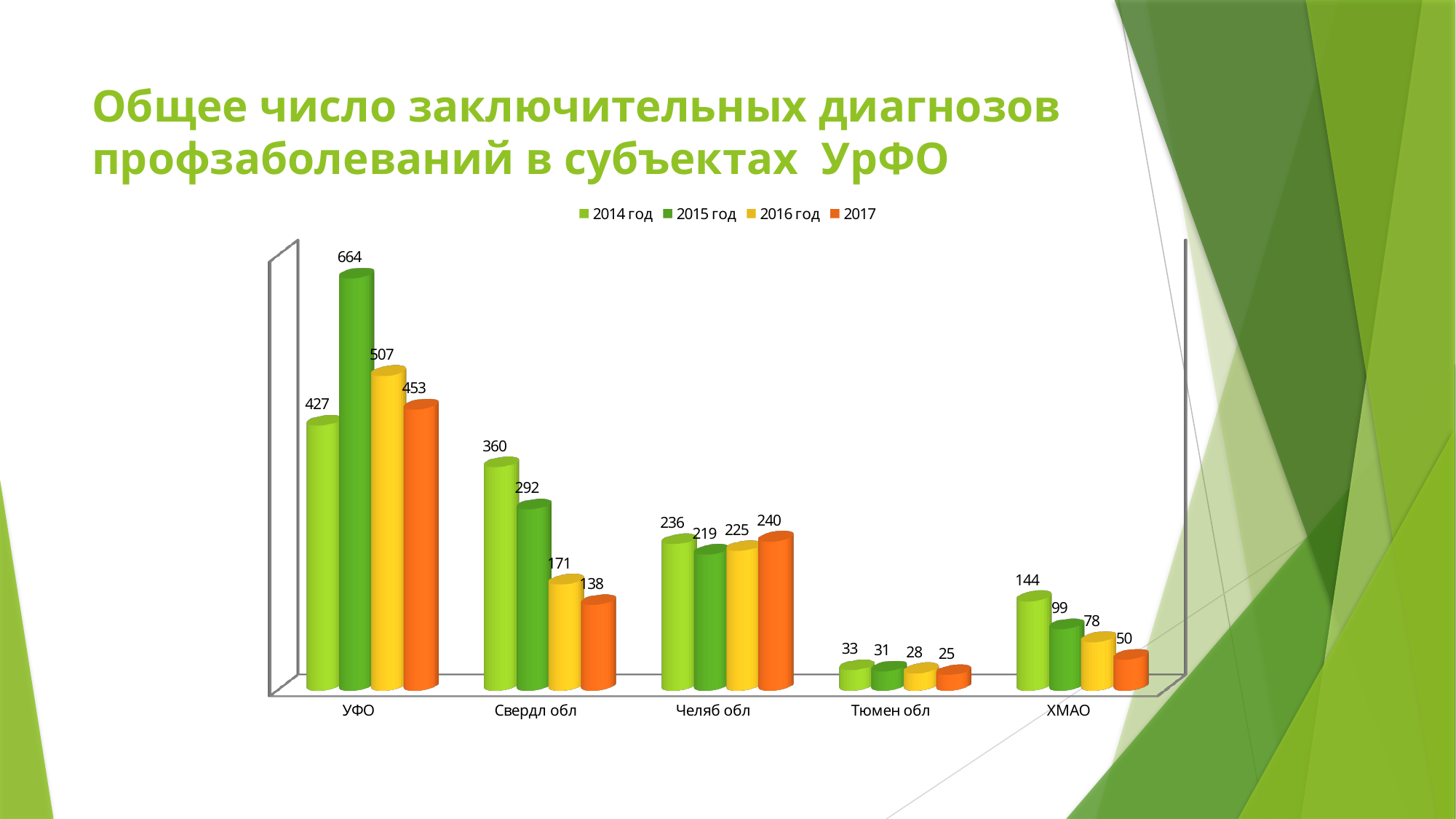
How many series does the legend list? 4 Which category has the highest value in the 2017 series? УФО What is the value for Свердл обл in the 2016 год series? 171 What is the value for ХМАО in the 2017 series? 50 How many categories are shown on the x axis? 5 Which category has the lowest value in the 2014 год series? Тюмен обл What is the value for УФО in the 2015 год series? 664 What kind of chart is shown on the slide? Bar chart What is the difference between the 2015 год and 2014 год values for УФО? 237 Which is larger for Челяб обл: the 2014 год value or the 2017 value? 2017 What is the difference between the 2014 год and 2017 values for Свердл обл? 222 What is the value for Челяб обл in the 2014 год series? 236